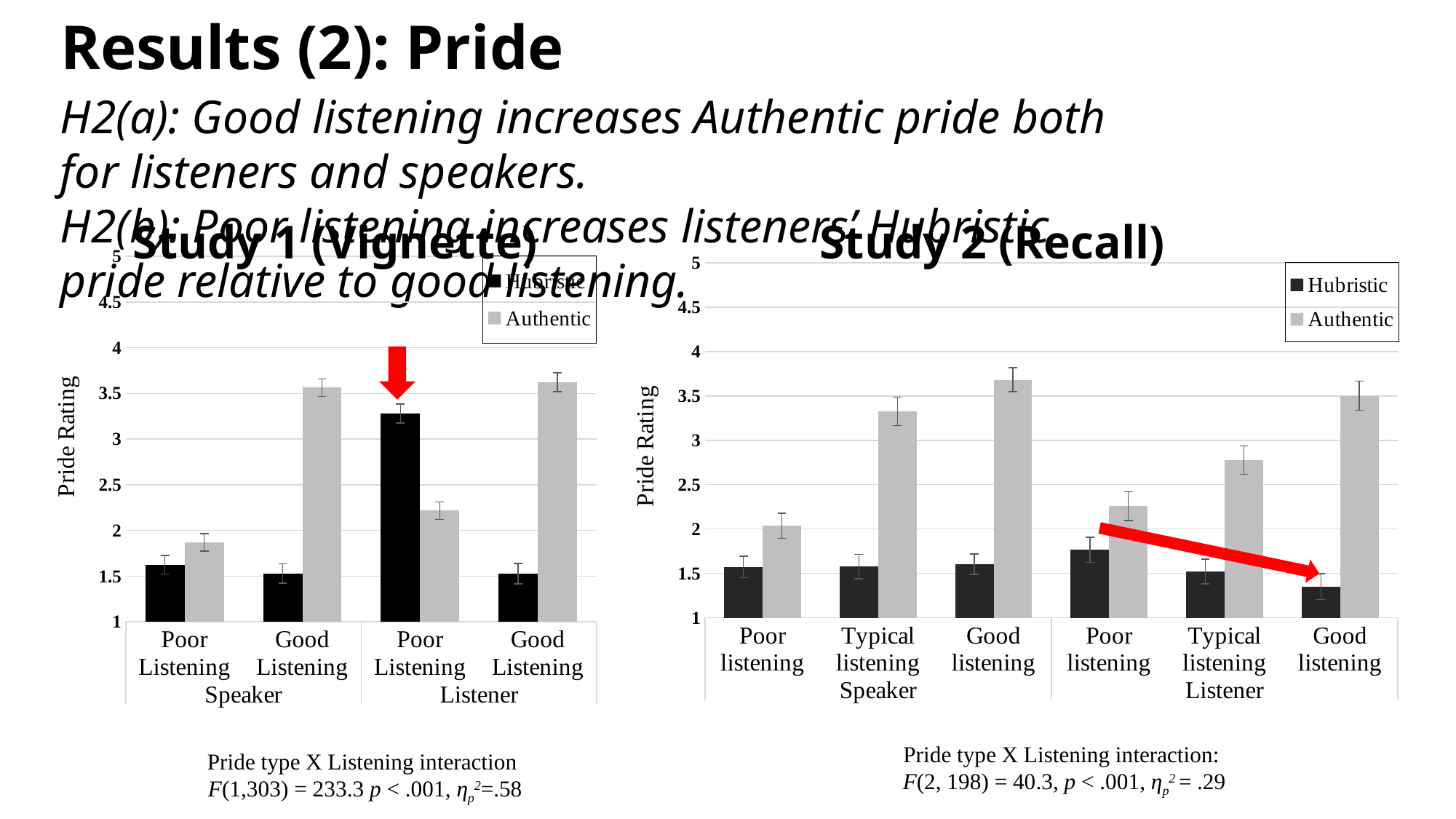
In the Study 1 (Vignette) chart, for Poor Listening (Listener), which is larger: Hubristic or Authentic? Hubristic In the Study 1 (Vignette) chart, is the Authentic value for Good Listening (Speaker) greater or less than 3? greater In the Study 2 (Recall) chart, is the Authentic value for Poor listening (Speaker) greater or less than 2.5? less In the Study 1 (Vignette) chart, which category has the highest Hubristic value? Poor Listening (Listener) What is the y-axis title of the Study 2 (Recall) chart? Pride Rating In the Study 2 (Recall) chart, which category has the lowest Hubristic value? Good listening (Listener) How many categories are shown on the x axis of the Study 2 (Recall) chart? 6 In the Study 1 (Vignette) chart, is the Hubristic value for Poor Listening (Listener) greater or less than 3? greater How many series does the legend of the Study 1 (Vignette) chart list? 2 How many categories are shown on the x axis of the Study 1 (Vignette) chart? 4 What kind of chart is the Study 1 (Vignette) chart? bar chart In the Study 2 (Recall) chart, which category has the highest Authentic value? Good listening (Speaker)